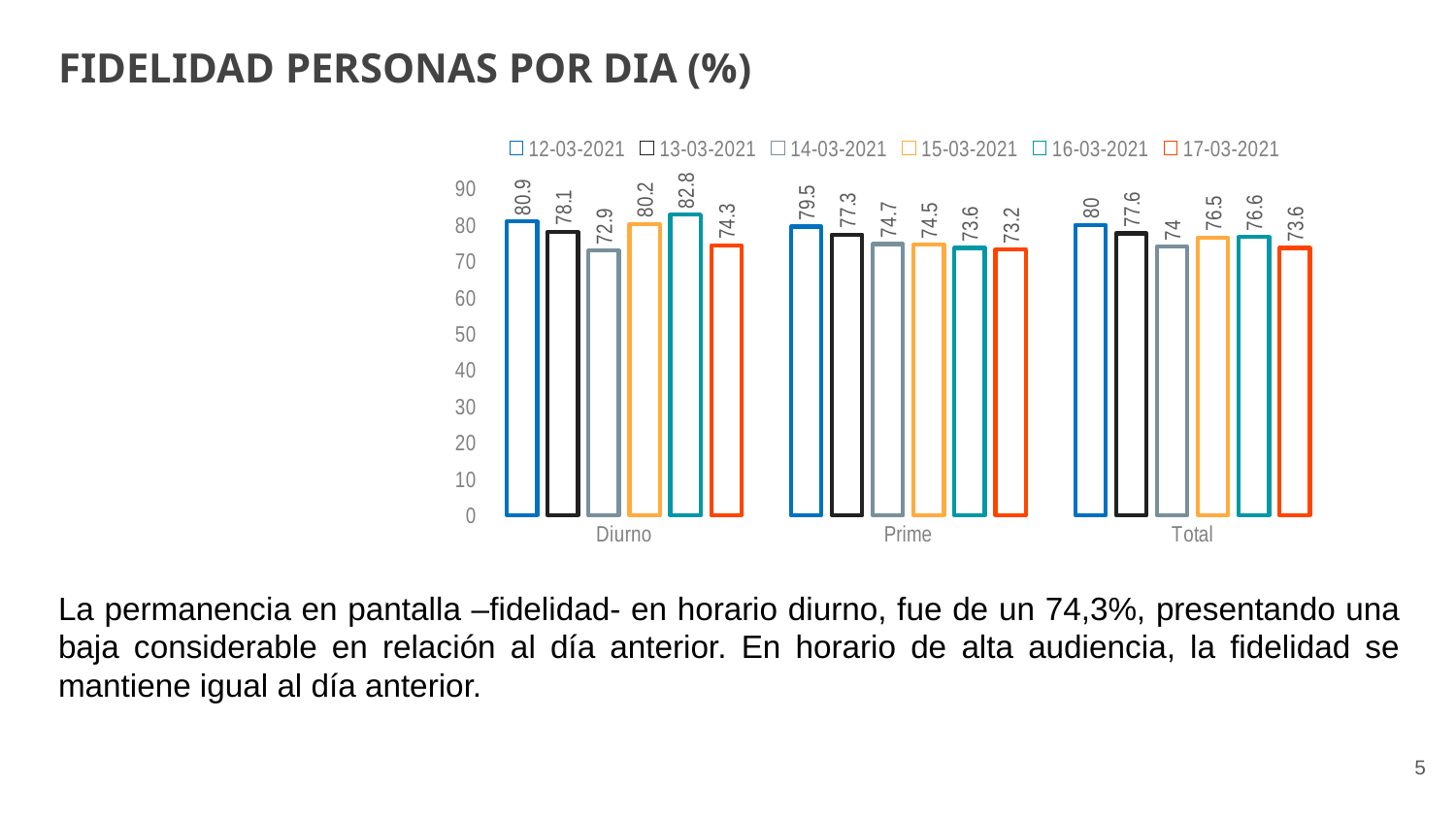
Which date has the lowest value in the Prime category? 17-03-2021 How many series does the legend list? 6 How many categories are shown on the x axis? 3 What is the value for 17-03-2021 in the Diurno category? 74.3 Which is larger in the Total category: the value for 15-03-2021 or the value for 16-03-2021? 16-03-2021 Which date has the highest value in the Diurno category? 16-03-2021 What is the value for 14-03-2021 in the Total category? 74 What is the title of the chart? FIDELIDAD PERSONAS POR DIA (%) Do the values in the Prime category rise or fall from 12-03-2021 to 17-03-2021? fall What is the difference between the 16-03-2021 and 17-03-2021 values in the Diurno category? 8.5 What is the value for 12-03-2021 in the Prime category? 79.5 What kind of chart is shown on the slide? bar chart